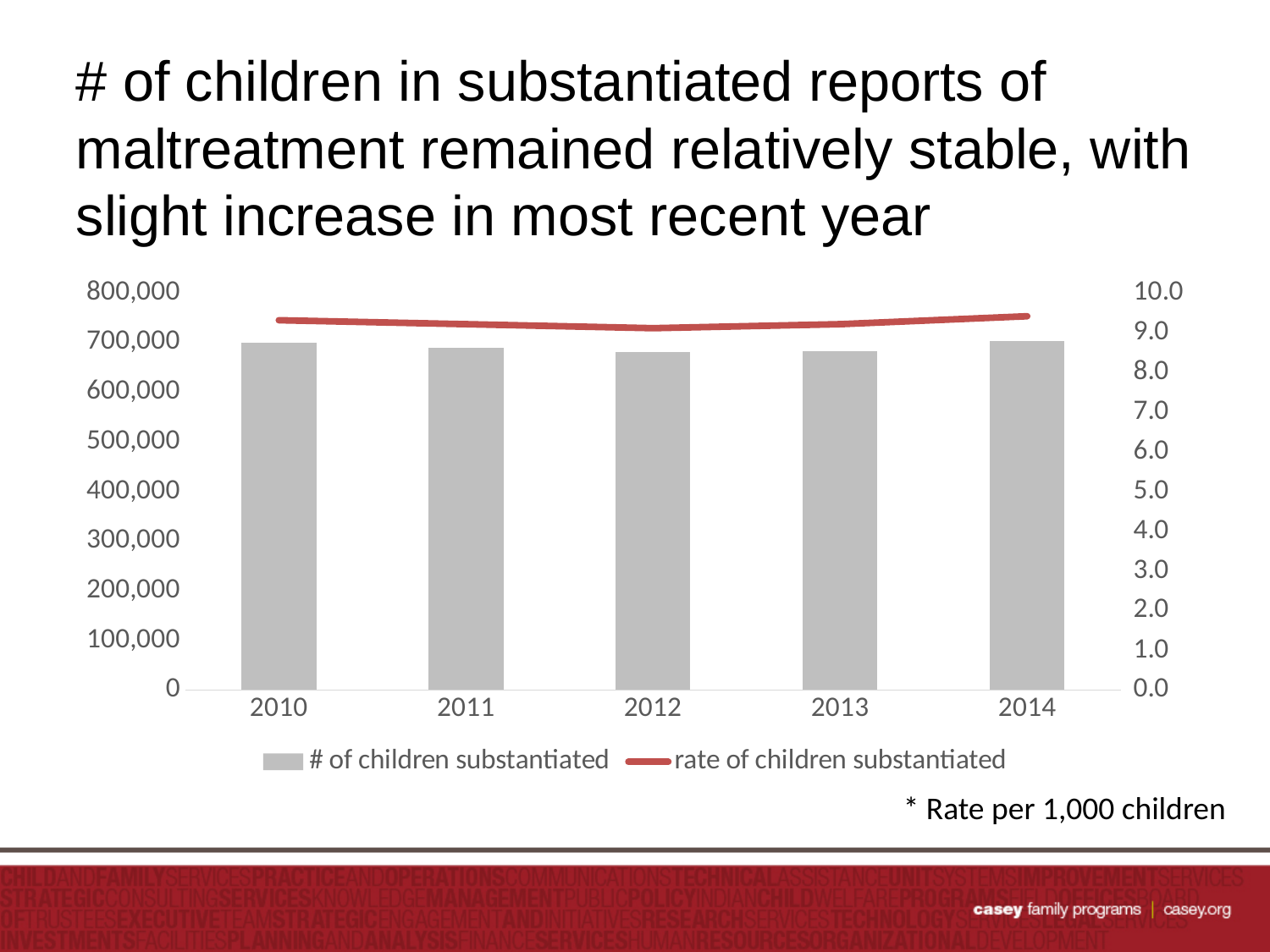
What is the first year shown on the x axis? 2010 How many series does the chart legend list? 2 Which series is plotted as a red line? rate of children substantiated Is the value for # of children substantiated in 2010 greater or less than 600,000? greater How many years are shown on the x axis of the chart? 5 Is the value for # of children substantiated in 2014 greater or less than 800,000? less Is the value for # of children substantiated in 2012 greater or less than 500,000? greater What is the last year shown on the x axis? 2014 According to the footnote, what is the rate expressed per? 1,000 children What kind of chart is shown on the slide? Combined bar and line chart